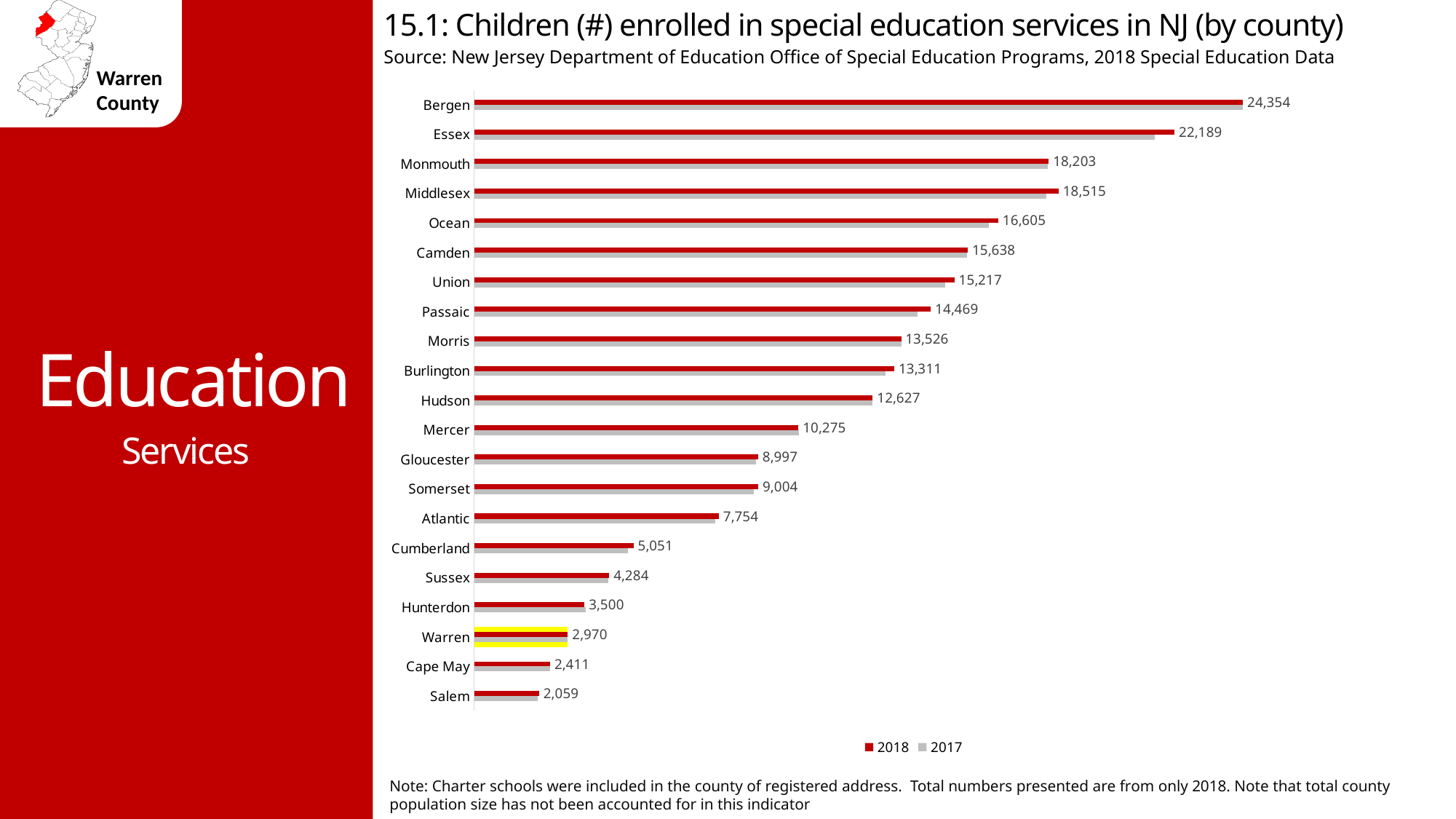
How much larger is Warren's 2018 value than Cape May's? 559 What type of chart is used on this slide? Bar chart How many series does the legend list? 2 What is the 2018 value for Warren County? 2,970 Which has the larger 2018 value, Somerset or Gloucester? Somerset How many counties are shown on the chart? 21 What is the difference between the 2018 values for Bergen and Essex? 2,165 What is the 2018 value shown for Hudson County? 12,627 Which county has the highest number of children enrolled in special education services in 2018? Bergen Which county has the lowest 2018 value on the chart? Salem Which county has the larger 2018 value, Middlesex or Monmouth? Middlesex How many children were enrolled in special education services in Bergen County in 2018? 24,354